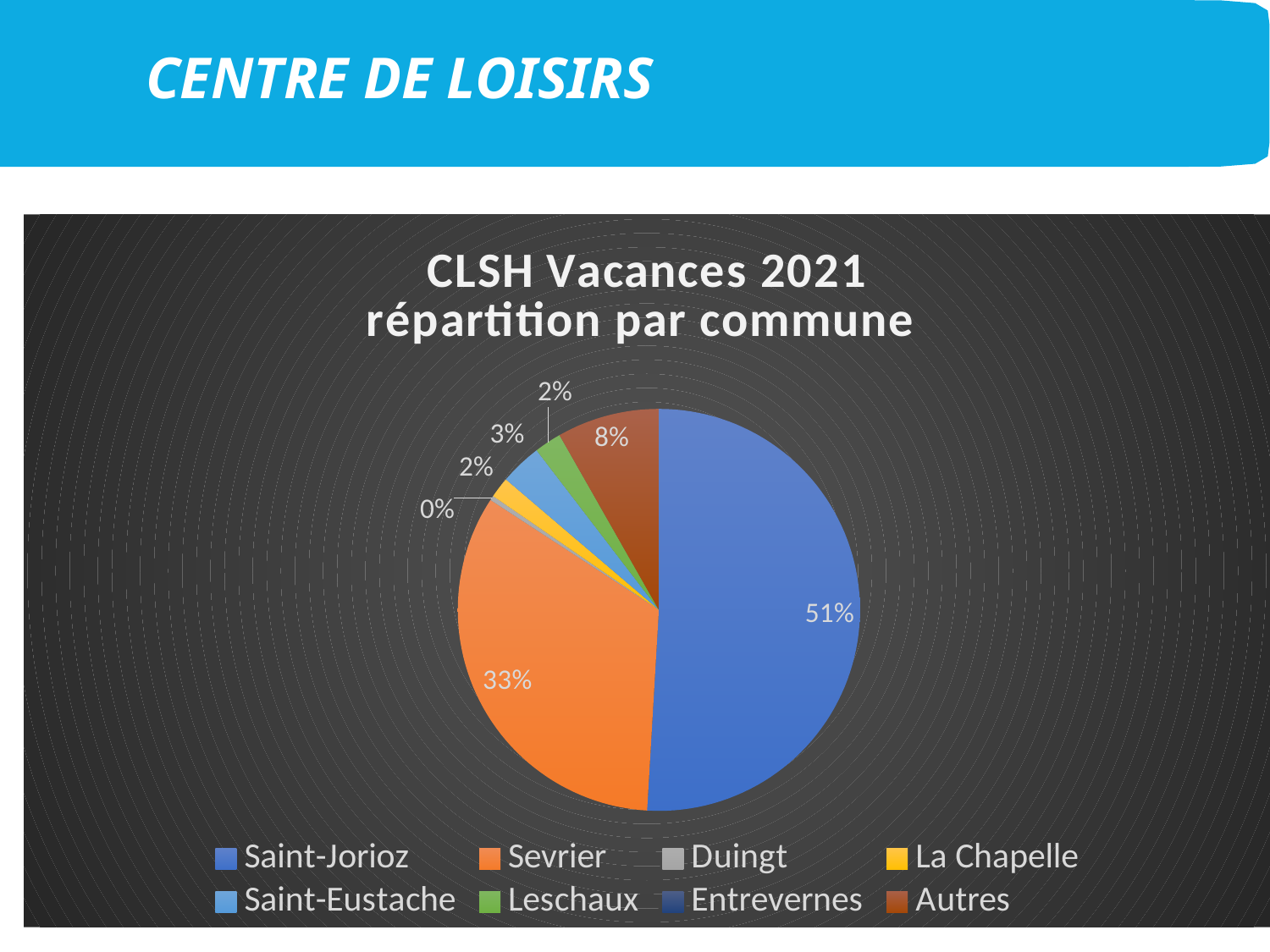
Which commune has the largest share of the pie? Saint-Jorioz What percentage is shown for Autres? 8% What share of the pie does Saint-Jorioz represent? 51% What percentage is shown for Saint-Eustache? 3% What is the title of the chart? CLSH Vacances 2021 répartition par commune By how many percentage points does Saint-Jorioz exceed Sevrier? 18 What percentage is shown for La Chapelle? 2% What kind of chart is shown on the slide? Pie chart What percentage is shown for Sevrier? 33% What percentage is shown for Duingt? 0% Which has the larger share, Autres or Saint-Eustache? Autres How many categories does the legend list? 8